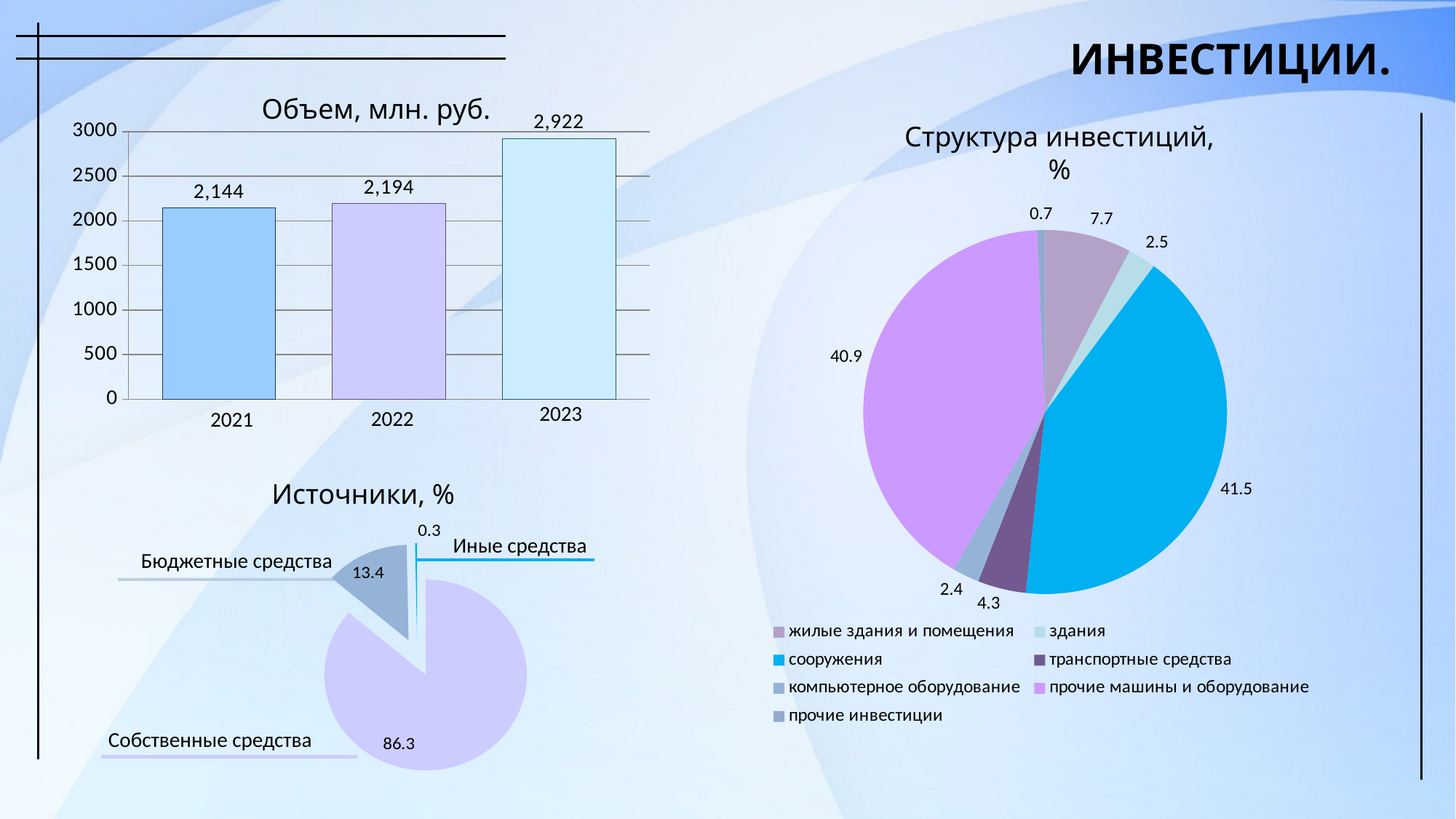
In the chart titled "Объем, млн. руб.", which year has the highest value? 2023 In the chart titled "Объем, млн. руб.", what is the difference between the 2023 and 2022 values? 728 In the chart titled "Структура инвестиций, %", which is larger: транспортные средства or компьютерное оборудование? транспортные средства In the chart titled "Структура инвестиций, %", what is the share for сооружения? 41.5 In the chart titled "Объем, млн. руб.", do the values rise or fall from 2021 to 2023? rise In the chart titled "Объем, млн. руб.", what is the value for 2023? 2,922 In the chart titled "Источники, %", what is the share for Собственные средства? 86.3 In the chart titled "Объем, млн. руб.", what is the value for 2021? 2,144 In the chart titled "Источники, %", which category has the smallest share? Иные средства In the chart titled "Структура инвестиций, %", how many categories does the legend list? 7 In the chart titled "Источники, %", how many categories are shown? 3 What kind of chart is the chart titled "Объем, млн. руб."? bar chart